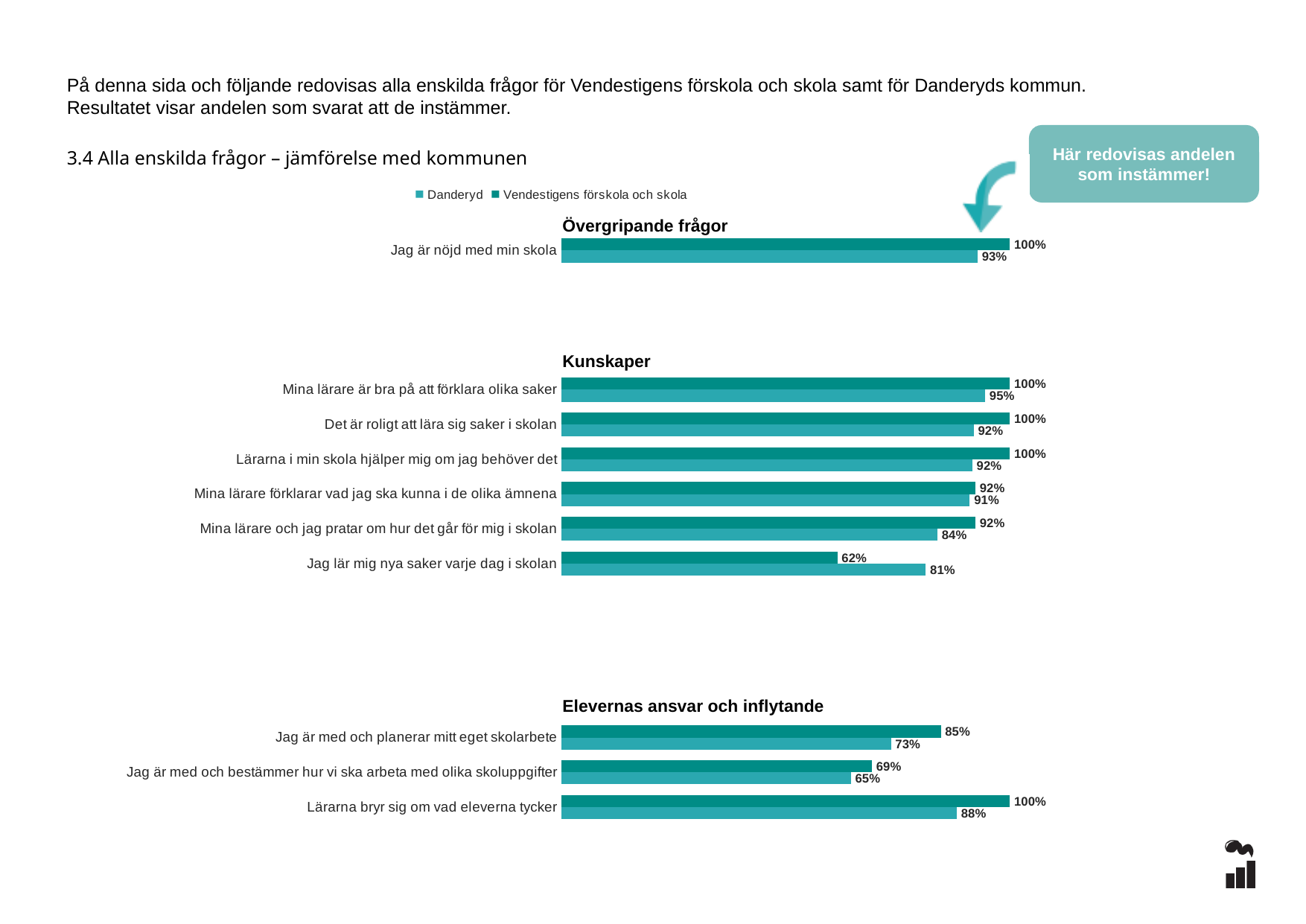
What are the two series named in the legend? Danderyd and Vendestigens förskola och skola In the Kunskaper chart, which question has the lowest value for Vendestigens förskola och skola? Jag lär mig nya saker varje dag i skolan In the Kunskaper chart, what is the value for Vendestigens förskola och skola for "Jag lär mig nya saker varje dag i skolan"? 62% In the Elevernas ansvar och inflytande chart, what is the difference between the Vendestigens förskola och skola value and the Danderyd value for "Lärarna bryr sig om vad eleverna tycker"? 12% In the Kunskaper chart, what is the Danderyd value for "Mina lärare och jag pratar om hur det går för mig i skolan"? 84% In the Elevernas ansvar och inflytande chart, which question has the lowest Danderyd value? Jag är med och bestämmer hur vi ska arbeta med olika skoluppgifter What kind of chart is the Elevernas ansvar och inflytande chart? Bar chart In the Kunskaper chart, for "Jag lär mig nya saker varje dag i skolan", which is larger: the Danderyd value or the Vendestigens förskola och skola value? Danderyd How many questions are plotted in the Kunskaper chart? 6 In the Övergripande frågor chart, what is the Danderyd value for "Jag är nöjd med min skola"? 93% In the Elevernas ansvar och inflytande chart, what is the value for Vendestigens förskola och skola for "Jag är med och planerar mitt eget skolarbete"? 85% How many series does the legend list? 2